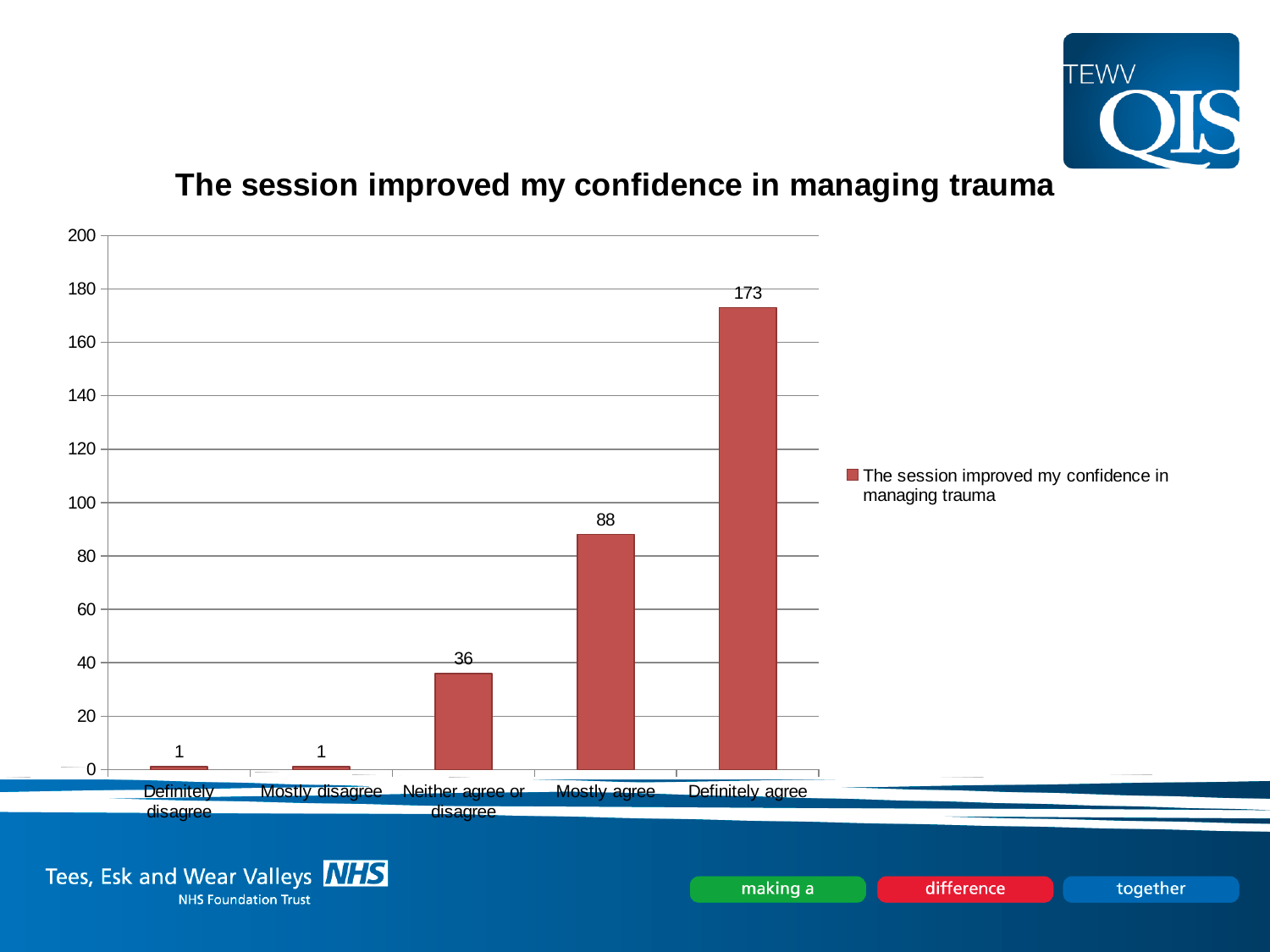
What kind of chart is shown? bar chart How many series does the legend list? 1 Which category has the highest value? Definitely agree What is the title of the chart? The session improved my confidence in managing trauma What is the value for Definitely agree? 173 How many categories are shown on the x axis? 5 Which is larger, the value for Mostly agree or the value for Neither agree or disagree? Mostly agree What is the difference between the values for Definitely agree and Mostly agree? 85 What is the value for Neither agree or disagree? 36 What is the value for Mostly disagree? 1 What is the value for Mostly agree? 88 Is the value for Definitely agree greater or less than 160? greater